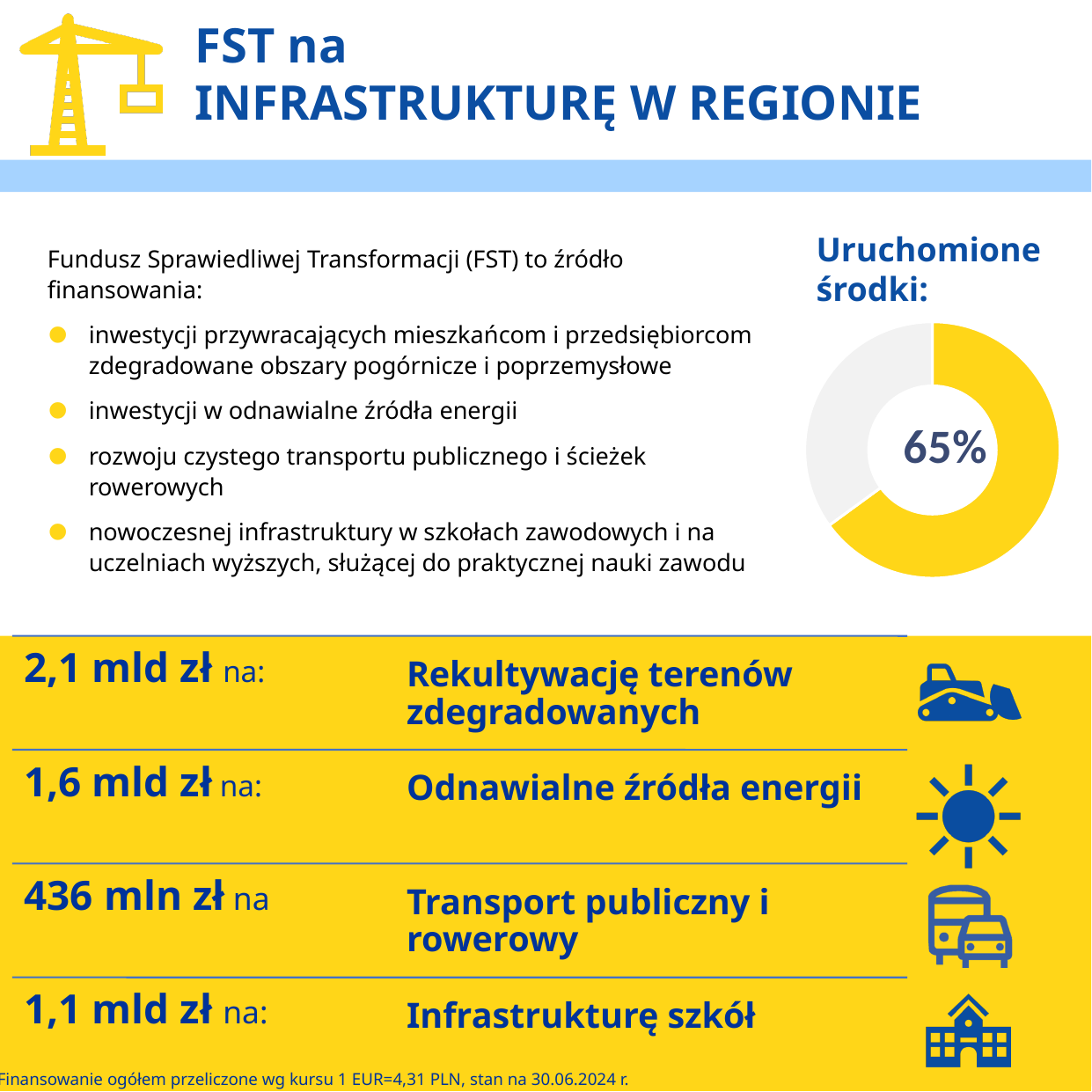
What percentage is shown in the centre of the donut chart titled "Uruchomione środki"? 65% What is the title above the donut chart on the slide? Uruchomione środki: What share of the donut chart does the yellow slice represent? 65% How many slices does the donut chart have? 2 What colour is the larger slice of the donut chart? yellow Which slice of the donut chart is larger, the yellow one or the grey one? yellow Is the share shown in the donut chart greater or less than 50%? greater What kind of chart is shown under the heading "Uruchomione środki"? donut (pie) chart